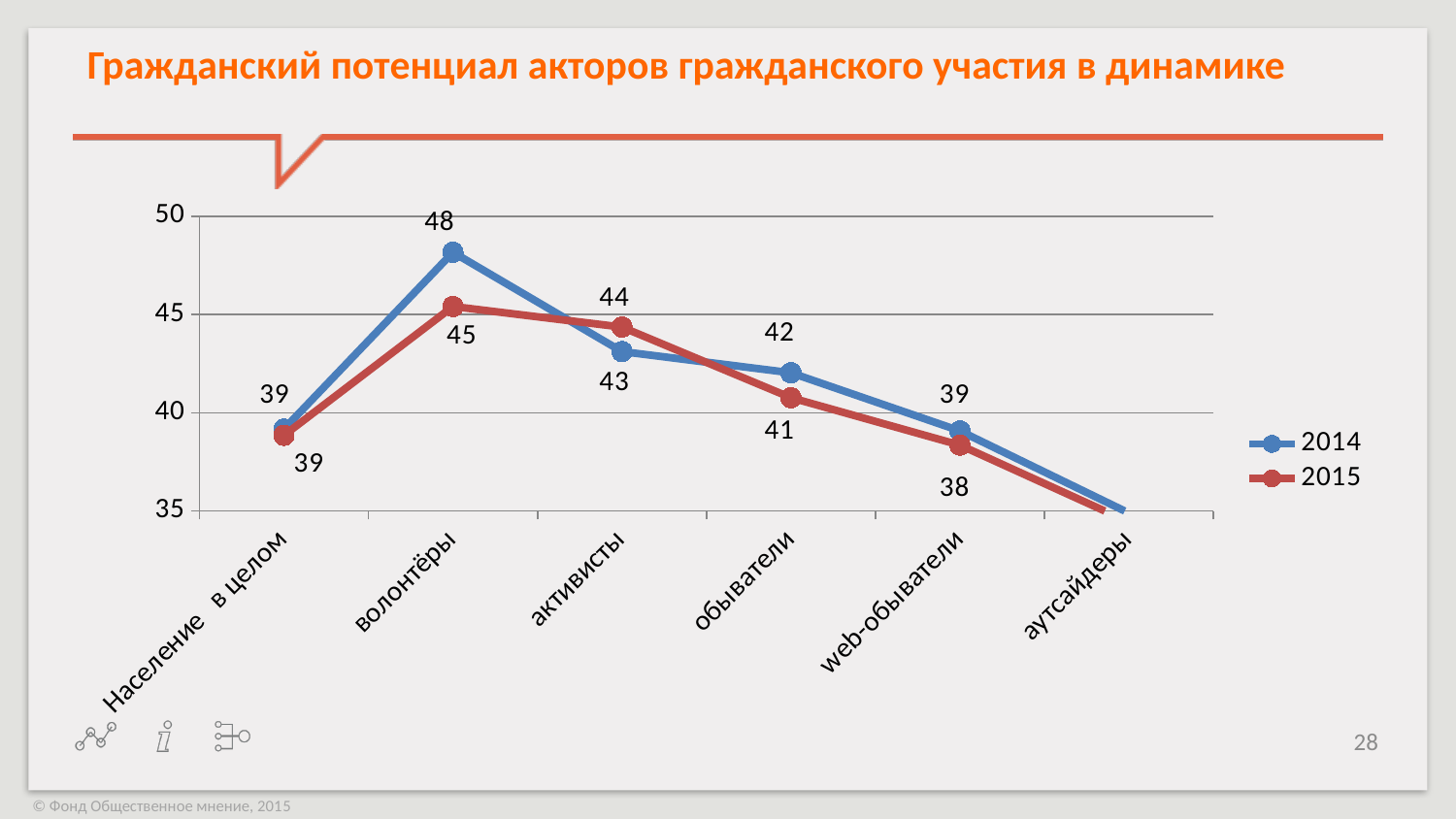
What is the difference between the 2014 and 2015 values for волонтёры? 3 For активисты, which series has the larger value, 2014 or 2015? 2015 How many series does the legend list? 2 Is the 2014 value for обыватели greater or less than 40? greater Which category has the highest 2014 value? волонтёры What type of chart is shown on the slide? line chart What is the 2015 value for web-обыватели? 38 How many categories are shown on the x axis? 6 Which category has the lowest 2015 value? аутсайдеры What is the 2015 value for активисты? 44 Which series is drawn in red? 2015 What is the 2014 value for волонтёры? 48